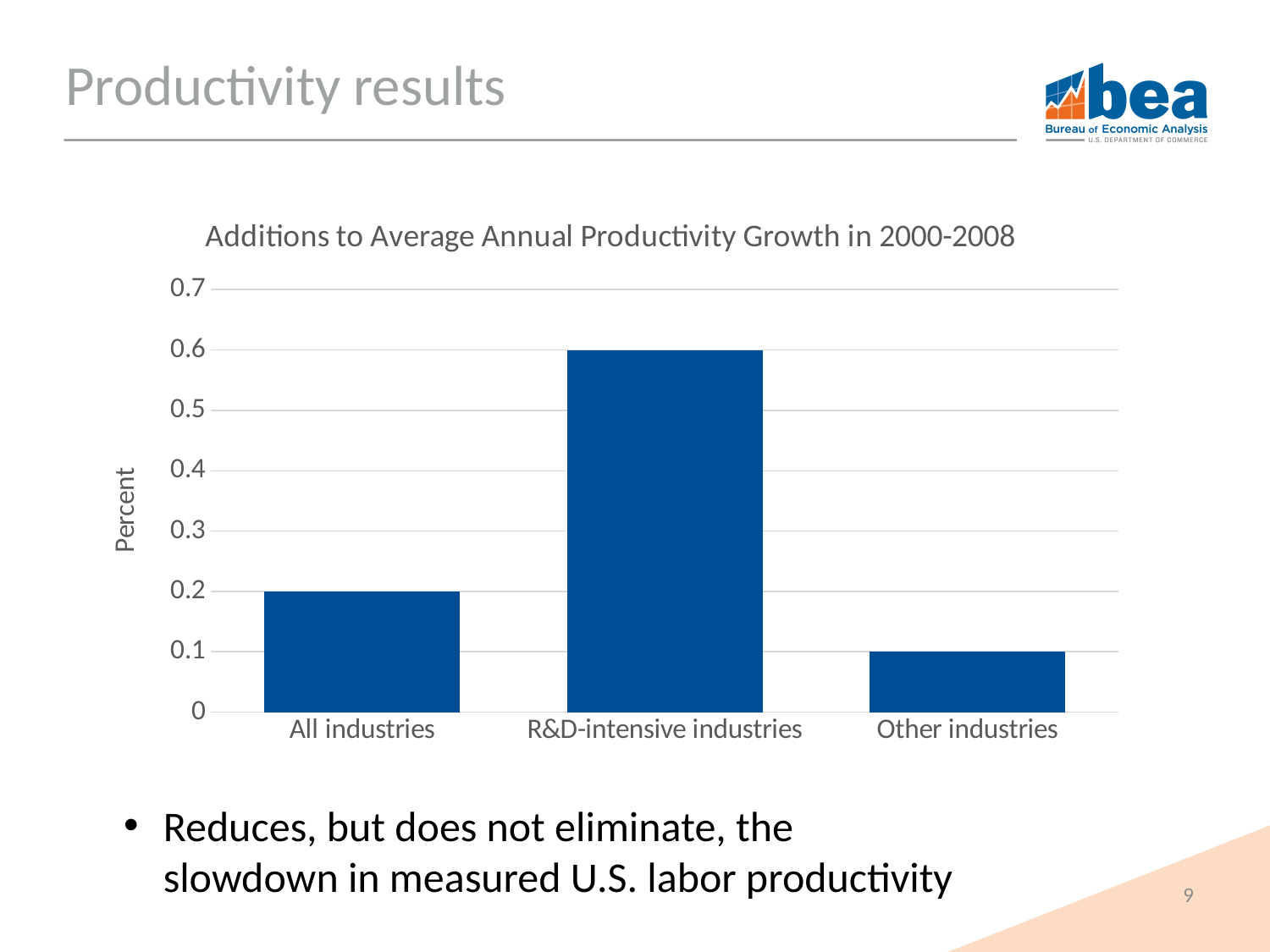
Which category has the lowest value? Other industries Which category has the highest value? R&D-intensive industries How many categories are shown on the x axis? 3 What is the title of the chart? Additions to Average Annual Productivity Growth in 2000-2008 What is the value for R&D-intensive industries? 0.6 What is the value for All industries? 0.2 Which is larger, the value for All industries or the value for Other industries? All industries What is the difference between the values for All industries and Other industries? 0.1 What is the difference between the values for R&D-intensive industries and All industries? 0.4 What kind of chart is shown on the slide? bar chart What is the value for Other industries? 0.1 Is the value for R&D-intensive industries greater or less than 0.5? greater